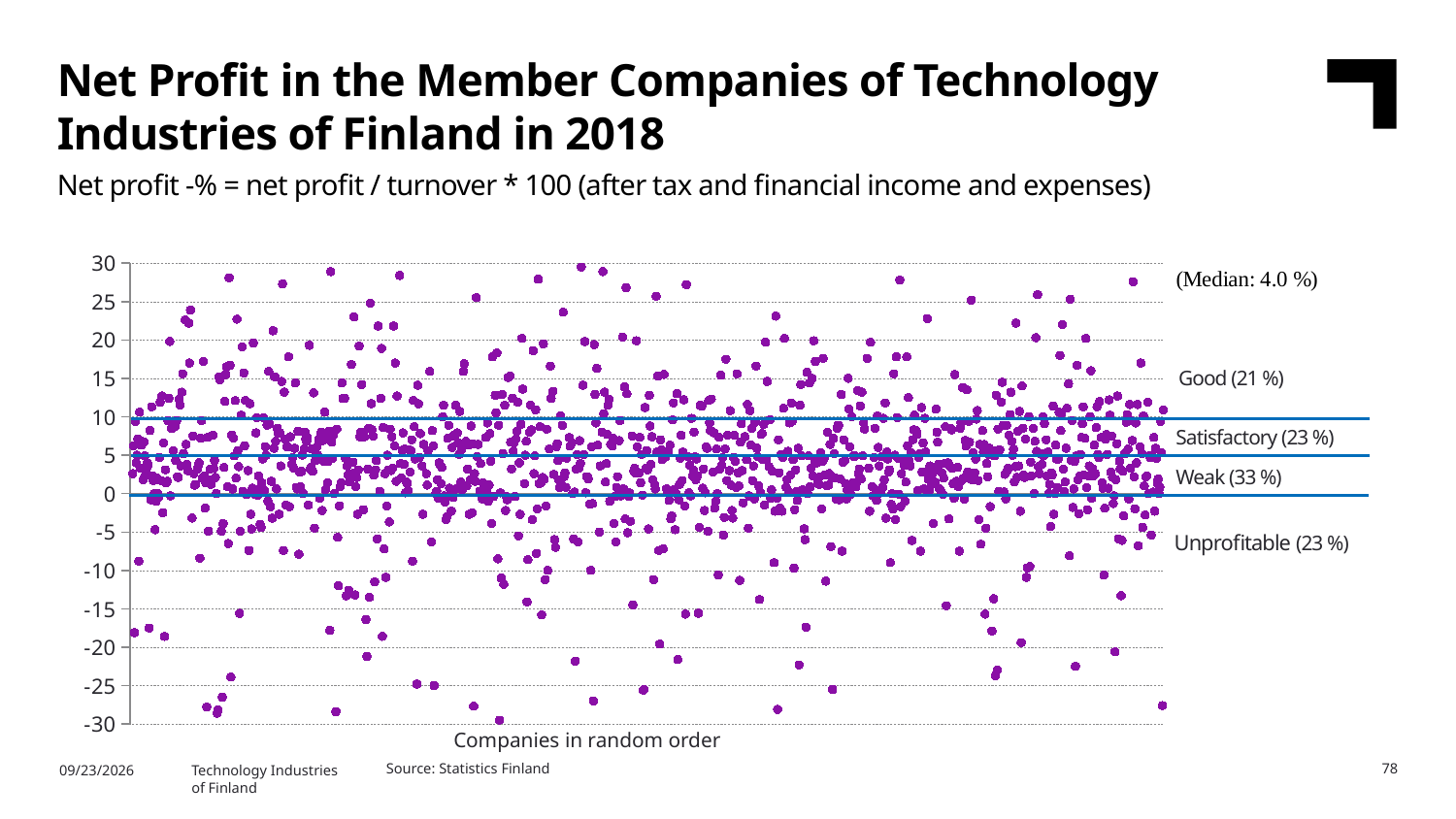
How many profitability categories are labelled on the chart? 4 What is the median net profit percentage stated on the chart? 4.0 % What kind of chart is shown on the slide? Scatter plot Which is larger, the share of 'Satisfactory' companies or the share of 'Good' companies? Satisfactory Which category has the smallest share of companies? Good What share of companies falls into the 'Weak' category? 33 % Which category has the largest share of companies? Weak What share of companies falls into the 'Good' category? 21 % What is the label of the x axis? Companies in random order How many percentage points larger is the 'Weak' share than the 'Good' share? 12 What share of companies falls into the 'Unprofitable' category? 23 % What share of companies falls into the 'Satisfactory' category? 23 %